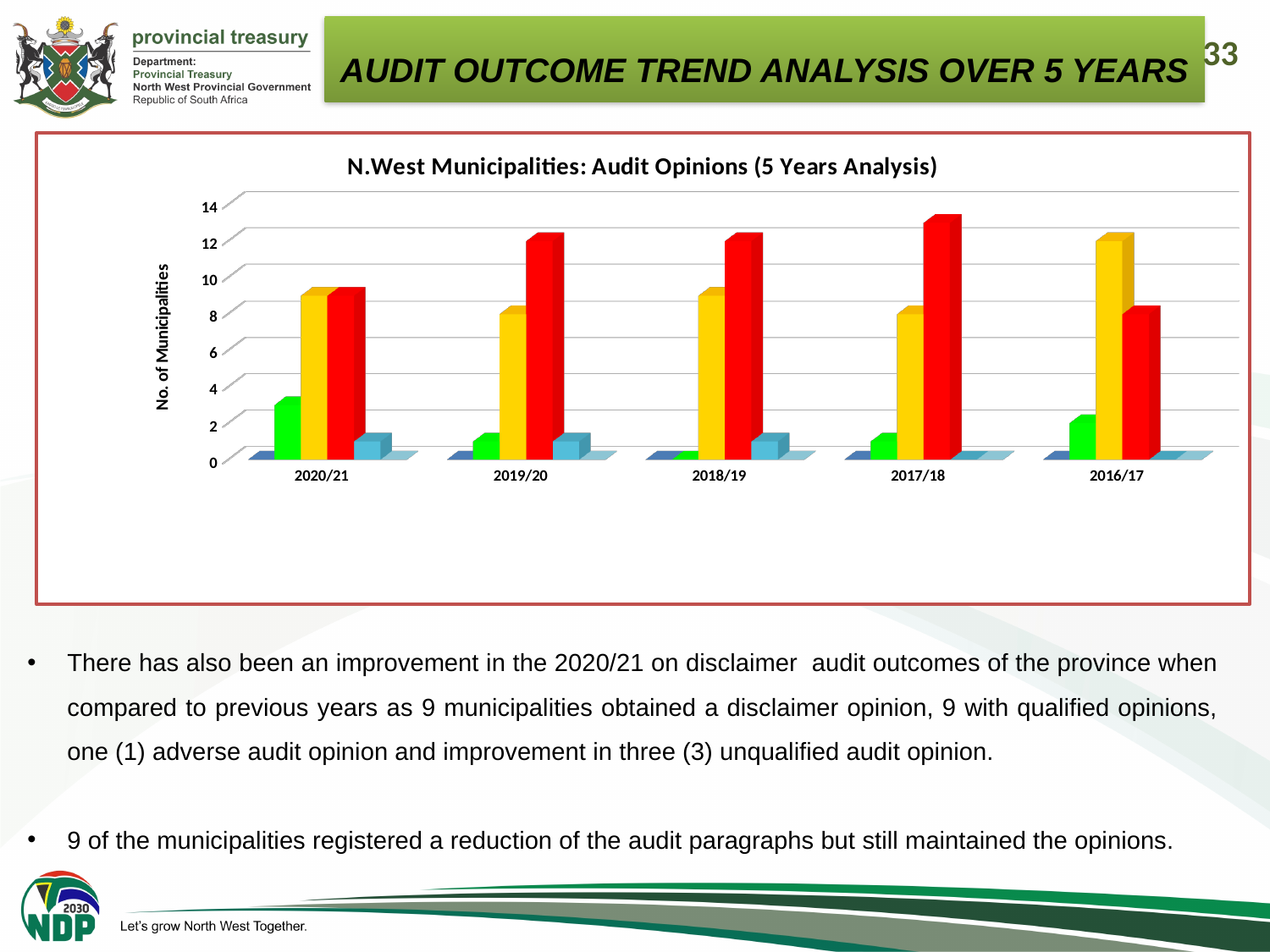
Which year has the tallest green bar? 2020/21 Is the value of the green bar for 2020/21 greater or less than 2? greater What type of chart is shown on the slide? Bar chart What is the title of the chart? N.West Municipalities: Audit Opinions (5 Years Analysis) Is the value of the red bar for 2020/21 greater or less than 12? less How many financial years are shown on the x axis of the chart? 5 What is the label on the vertical axis of the chart? No. of Municipalities Which is larger, the red bar for 2017/18 or the red bar for 2016/17? 2017/18 Is the value of the red bar for 2016/17 greater or less than 10? less Which year has the tallest red bar? 2017/18